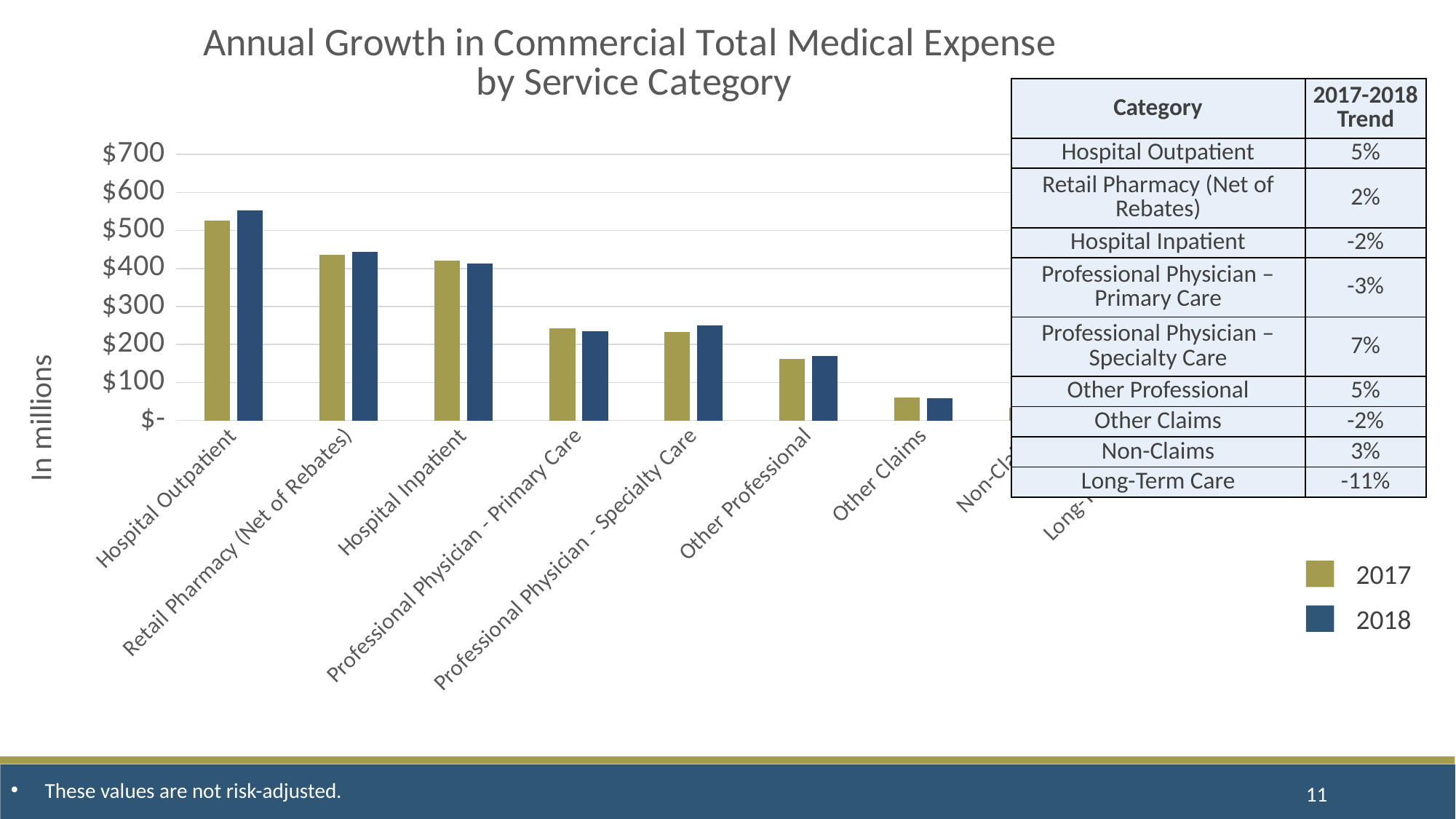
Is the 2018 value for Other Claims greater or less than $100? less Is the 2017 value for Hospital Outpatient greater or less than $500? greater Is the 2018 value for Retail Pharmacy (Net of Rebates) greater or less than $400? greater How many series does the legend list? 2 What kind of chart is shown on the slide? bar chart What is the label on the vertical axis of the chart? In millions What are the two series named in the legend? 2017 and 2018 Which service category has the highest total medical expense in the chart? Hospital Outpatient For Hospital Outpatient, which year has the larger value, 2017 or 2018? 2018 Do the bar values generally rise or fall moving from left to right along the x axis? fall